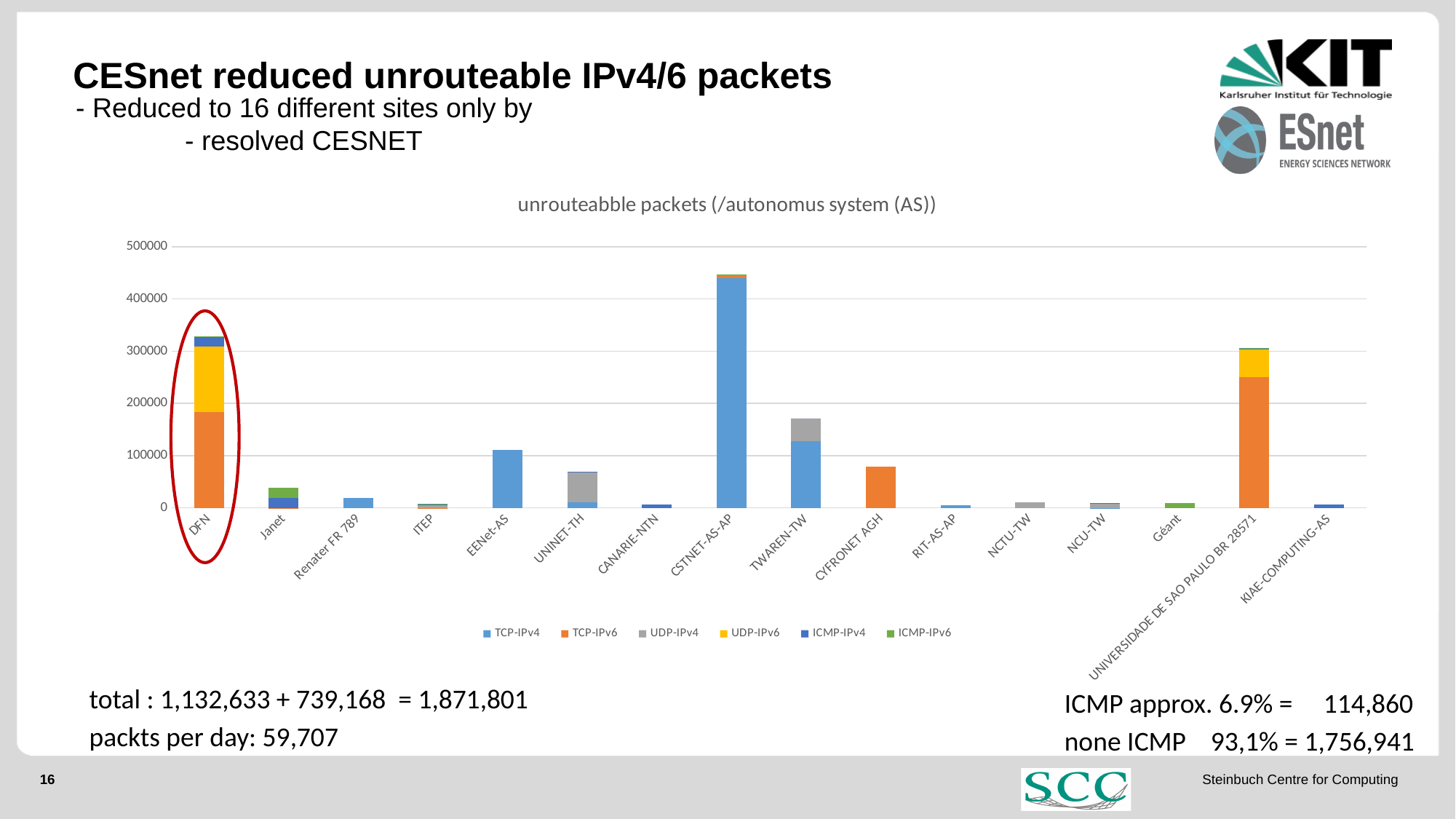
Which has a taller bar, DFN or UNIVERSIDADE DE SAO PAULO BR 28571? DFN Is the total bar for DFN greater or less than 300000? greater Is the total bar for EENet-AS greater or less than 200000? less What kind of chart is shown on the slide? stacked bar chart Which has a taller bar, CYFRONET AGH or EENet-AS? EENet-AS What is the title of the chart? unrouteabble packets (/autonomus system (AS)) Which autonomous system has the tallest bar in the chart? CSTNET-AS-AP Is the total bar for TWAREN-TW greater or less than 100000? greater Which series is shown in yellow in the chart legend? UDP-IPv6 How many series does the chart legend list? 6 How many autonomous systems (categories) are shown on the x axis of the chart? 16